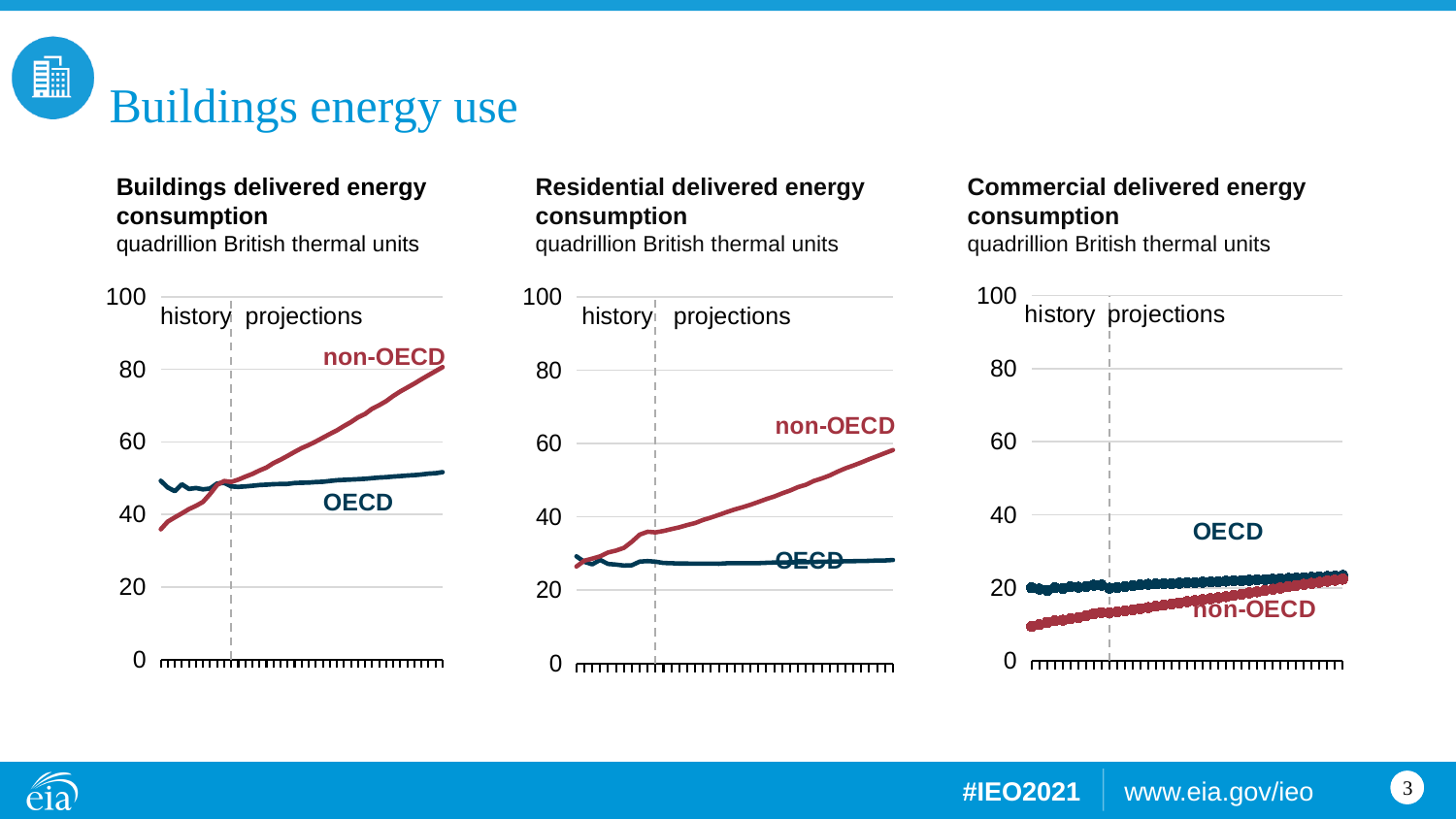
On the 'Residential delivered energy consumption' chart, is the OECD value at the end of the projections greater or less than 40? less On the 'Commercial delivered energy consumption' chart, is the non-OECD value at the start of the history period greater or less than 20? less What kind of chart is the 'Buildings delivered energy consumption' chart? line chart How many series are plotted on the 'Residential delivered energy consumption' chart? 2 On the 'Commercial delivered energy consumption' chart, does the non-OECD line rise or fall along the x axis? rise On the 'Buildings delivered energy consumption' chart, which series is higher at the end of the projection period, OECD or non-OECD? non-OECD What unit is used on the y axis of the 'Commercial delivered energy consumption' chart? quadrillion British thermal units On the 'Buildings delivered energy consumption' chart, is the non-OECD value at the end of the projections greater or less than 60? greater On the 'Buildings delivered energy consumption' chart, does the non-OECD line rise or fall over the projection period? rise What two periods does the dashed vertical line separate on the 'Residential delivered energy consumption' chart? history and projections